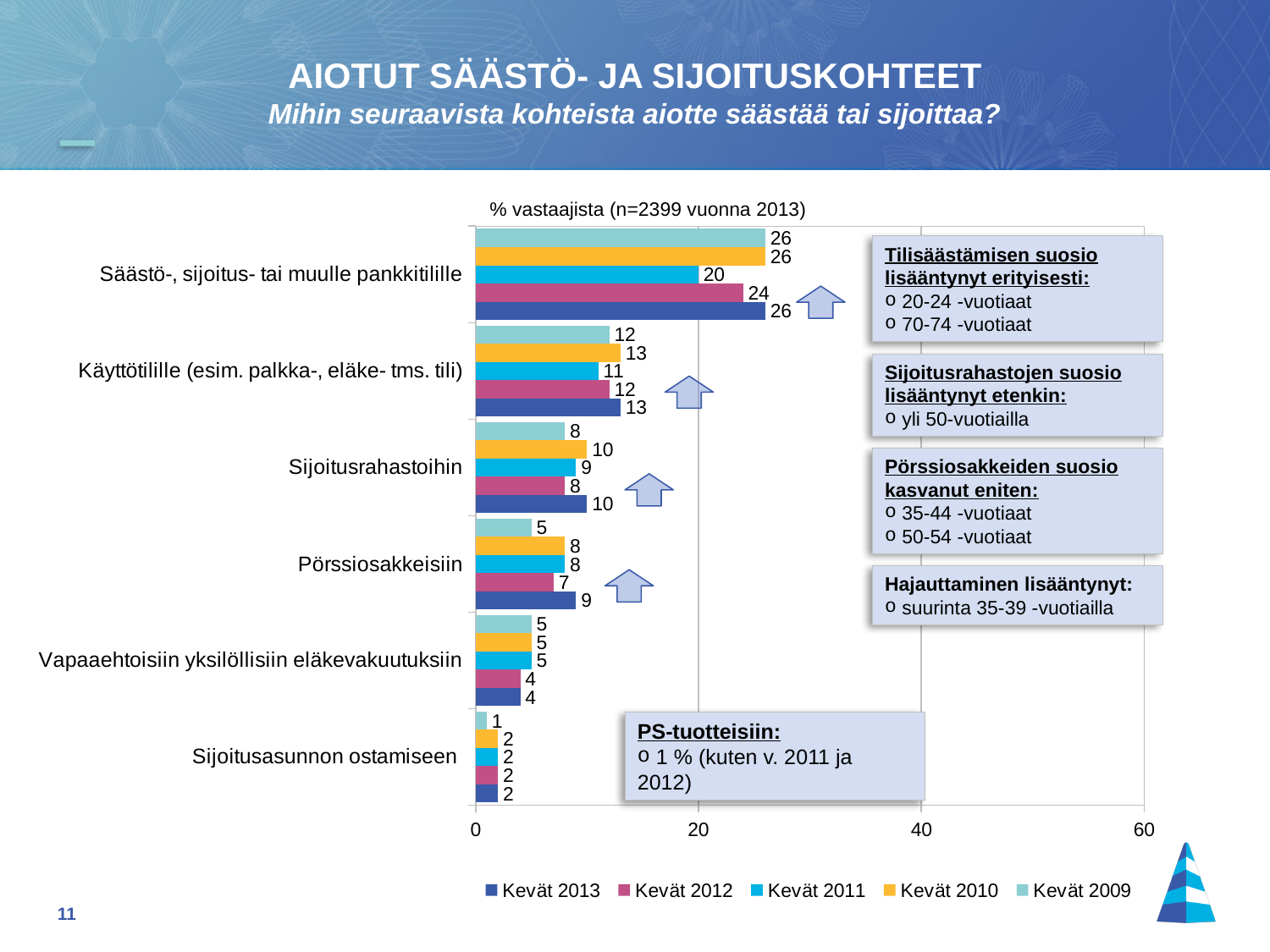
How many series does the legend list? 5 What is the Kevät 2013 value for Säästö-, sijoitus- tai muulle pankkitilille? 26 Which category has the lowest Kevät 2013 value? Sijoitusasunnon ostamiseen Which category has the highest Kevät 2013 value? Säästö-, sijoitus- tai muulle pankkitilille What type of chart is shown on the slide? bar chart What is the unit label shown above the chart? % vastaajista (n=2399 vuonna 2013) Which is larger for Pörssiosakkeisiin: the Kevät 2013 value or the Kevät 2009 value? Kevät 2013 How many categories are shown on the chart? 6 What is the Kevät 2011 value for Säästö-, sijoitus- tai muulle pankkitilille? 20 What is the Kevät 2013 value for Pörssiosakkeisiin? 9 What is the difference between the Kevät 2013 and Kevät 2012 values for Säästö-, sijoitus- tai muulle pankkitilille? 2 What is the Kevät 2009 value for Sijoitusasunnon ostamiseen? 1